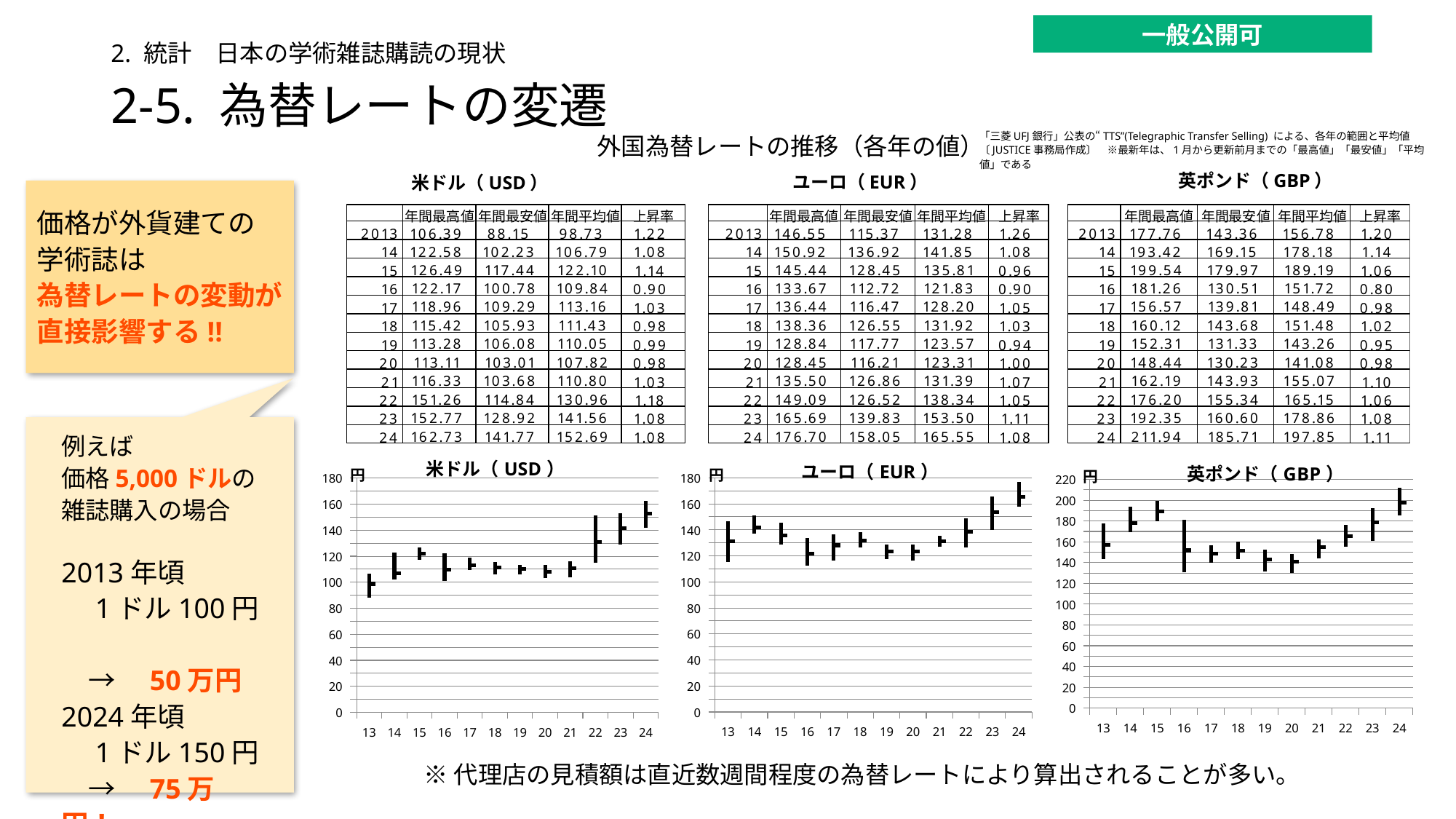
In the ユーロ (EUR) chart, is the value for 16 greater or less than 140? less In the 米ドル (USD) chart, is the value for 13 greater or less than 120? less According to the ユーロ (EUR) table, what is the 年間最高値 for 2013? 146.55 In the 米ドル (USD) chart, do the values rise or fall from 21 to 24? rise What kind of chart is used for the 米ドル (USD) chart at the bottom of the slide? high-low (stock) chart In the 米ドル (USD) chart, which year has the lowest value? 13 In the 米ドル (USD) chart, how many years are plotted along the x axis? 12 In the 英ポンド (GBP) chart, which year reaches the highest value? 24 According to the 英ポンド (GBP) table, what is the difference between the 年間最高値 for 24 and for 2013? 34.18 In the 英ポンド (GBP) chart, is the value for 24 greater or less than 180? greater In the 米ドル (USD) chart, which year is higher, 22 or 20? 22 According to the 米ドル (USD) table, what is the 年間平均値 for 24? 152.69